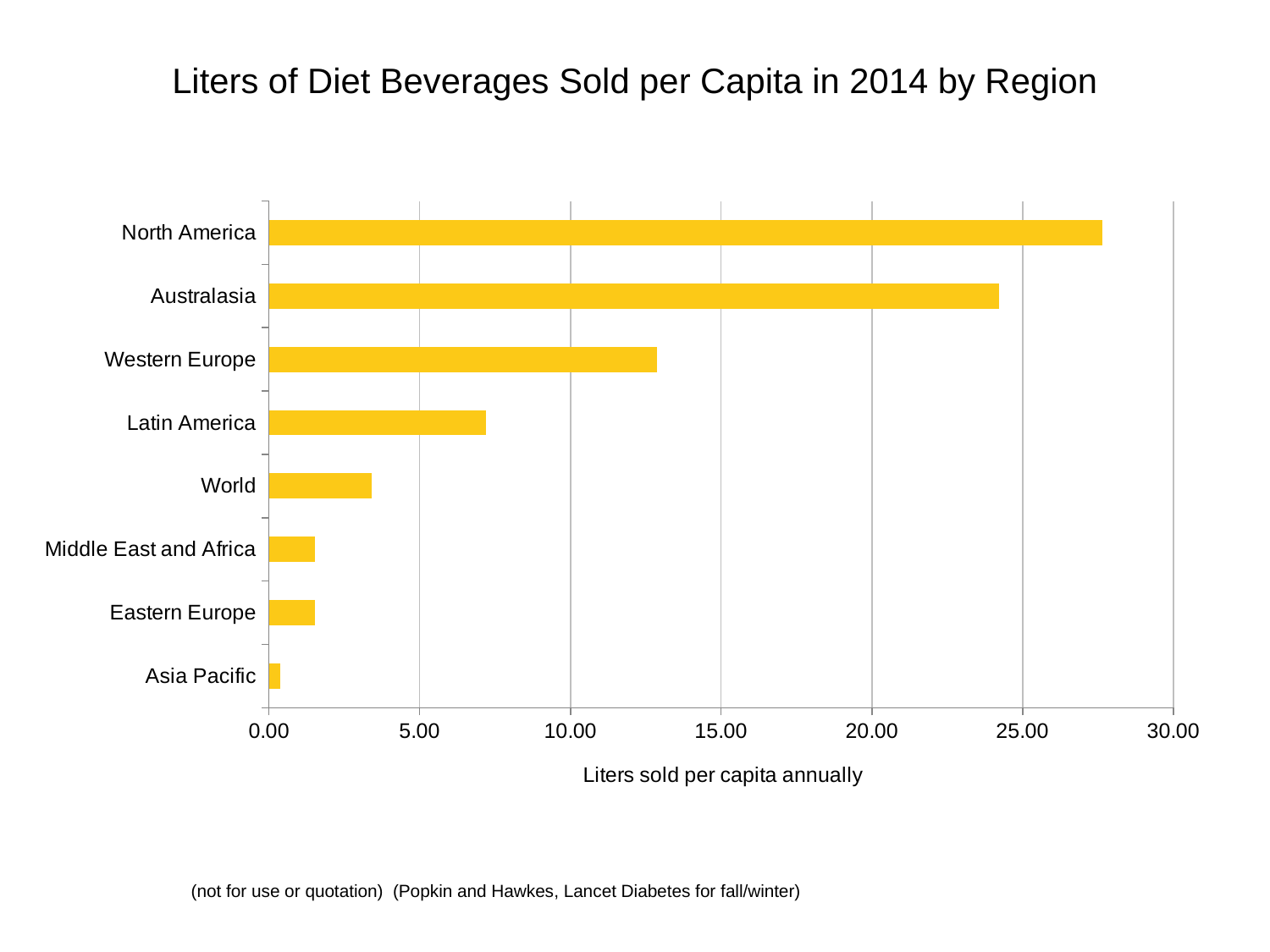
Which region has the lowest liters of diet beverages sold per capita? Asia Pacific Which has a larger value, Western Europe or Latin America? Western Europe What kind of chart is shown on the slide? bar chart What is the label of the horizontal axis? Liters sold per capita annually How many regions are plotted in the chart? 8 Is the value for World greater or less than 5.00? less Which has a larger value, Australasia or Western Europe? Australasia Which region has the highest liters of diet beverages sold per capita? North America Is the value for Western Europe greater or less than 10.00? greater Is the value for North America greater or less than 25.00? greater